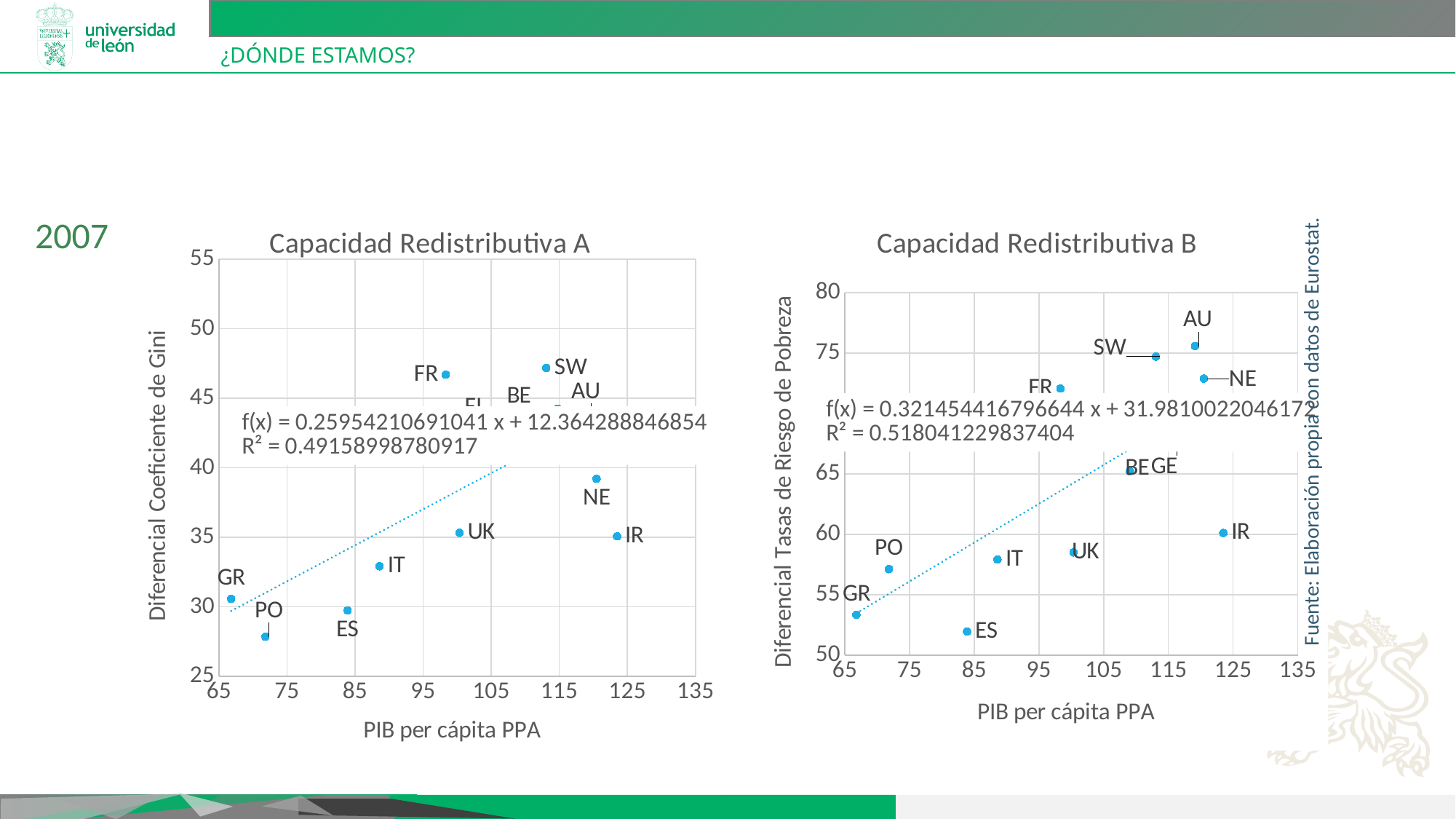
What is the x-axis label of 'Capacidad Redistributiva B'? PIB per cápita PPA In 'Capacidad Redistributiva A', which country has the lowest Diferencial Coeficiente de Gini? PO In 'Capacidad Redistributiva A', which has a higher Diferencial Coeficiente de Gini, NE or IR? NE In 'Capacidad Redistributiva B', is the value for ES greater or less than 55? less In 'Capacidad Redistributiva B', which has a higher Diferencial Tasas de Riesgo de Pobreza, FR or IT? FR What kind of chart is 'Capacidad Redistributiva A'? scatter chart In 'Capacidad Redistributiva A', is the value for PO greater or less than 30? less In 'Capacidad Redistributiva A', do the values generally rise or fall as PIB per cápita PPA increases? rise In 'Capacidad Redistributiva A', is the value for FR greater or less than 45? greater What is the R² value shown on 'Capacidad Redistributiva A'? 0.49158998780917 In 'Capacidad Redistributiva B', do the values generally rise or fall as PIB per cápita PPA increases? rise